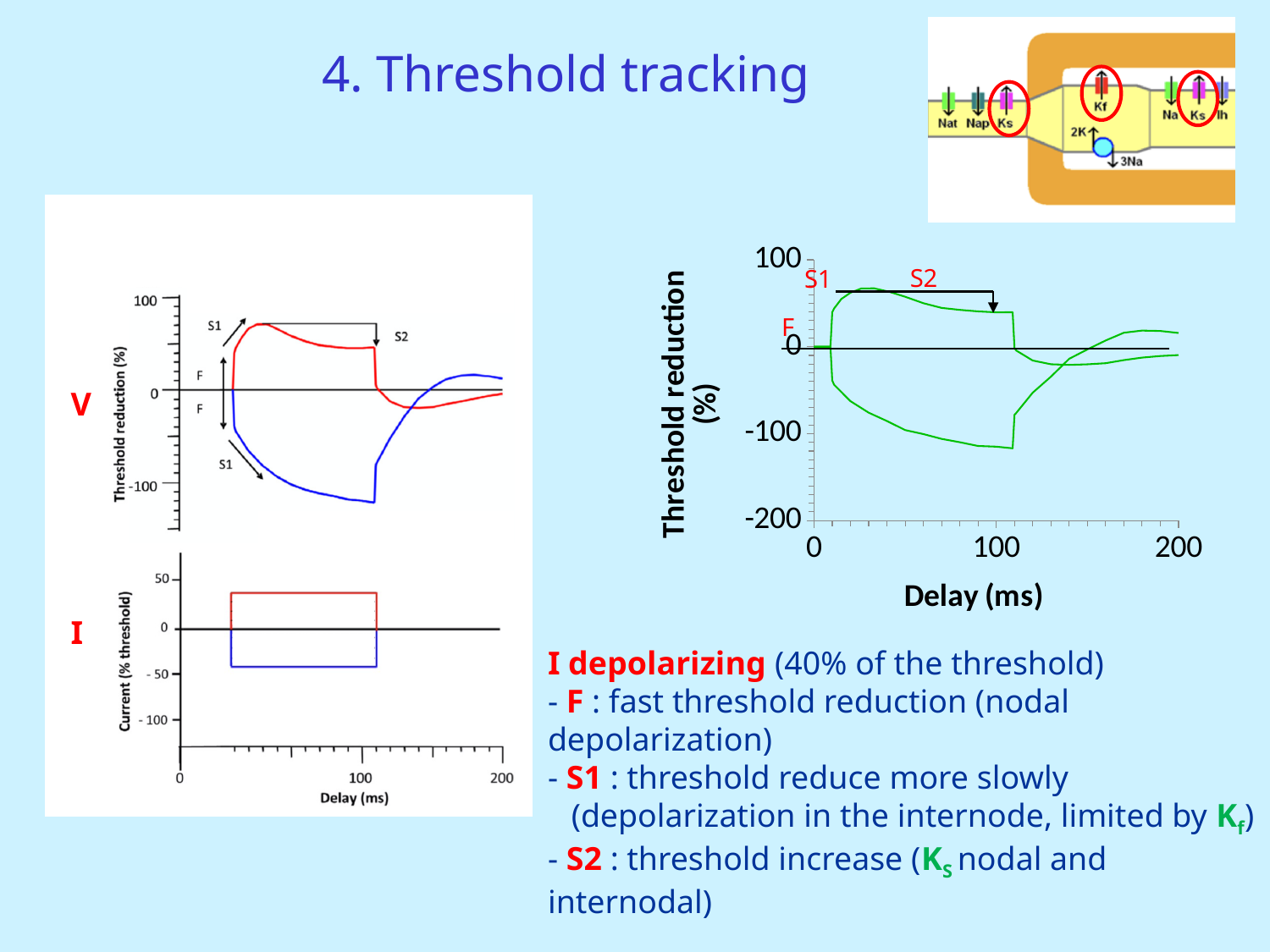
On the right-hand chart, is the value of the lower green curve at a delay of 100 ms greater or less than -100? less On the right-hand chart, is the value of the upper green curve at a delay of 50 ms greater or less than 0? greater On the right-hand chart, is the value of the lower green curve at a delay of 50 ms greater or less than 0? less On the right-hand chart, how many green curves are plotted? 2 On the right-hand chart, what is the lowest value shown on the y axis? -200 On the right-hand chart, between delays of 30 ms and 100 ms, does the lower green curve rise or fall? fall What kind of chart is the chart on the right of the slide, with the y axis labelled 'Threshold reduction (%)'? line chart On the right-hand chart, what is the label of the y axis? Threshold reduction (%) On the right-hand chart, what is the label of the x axis? Delay (ms)